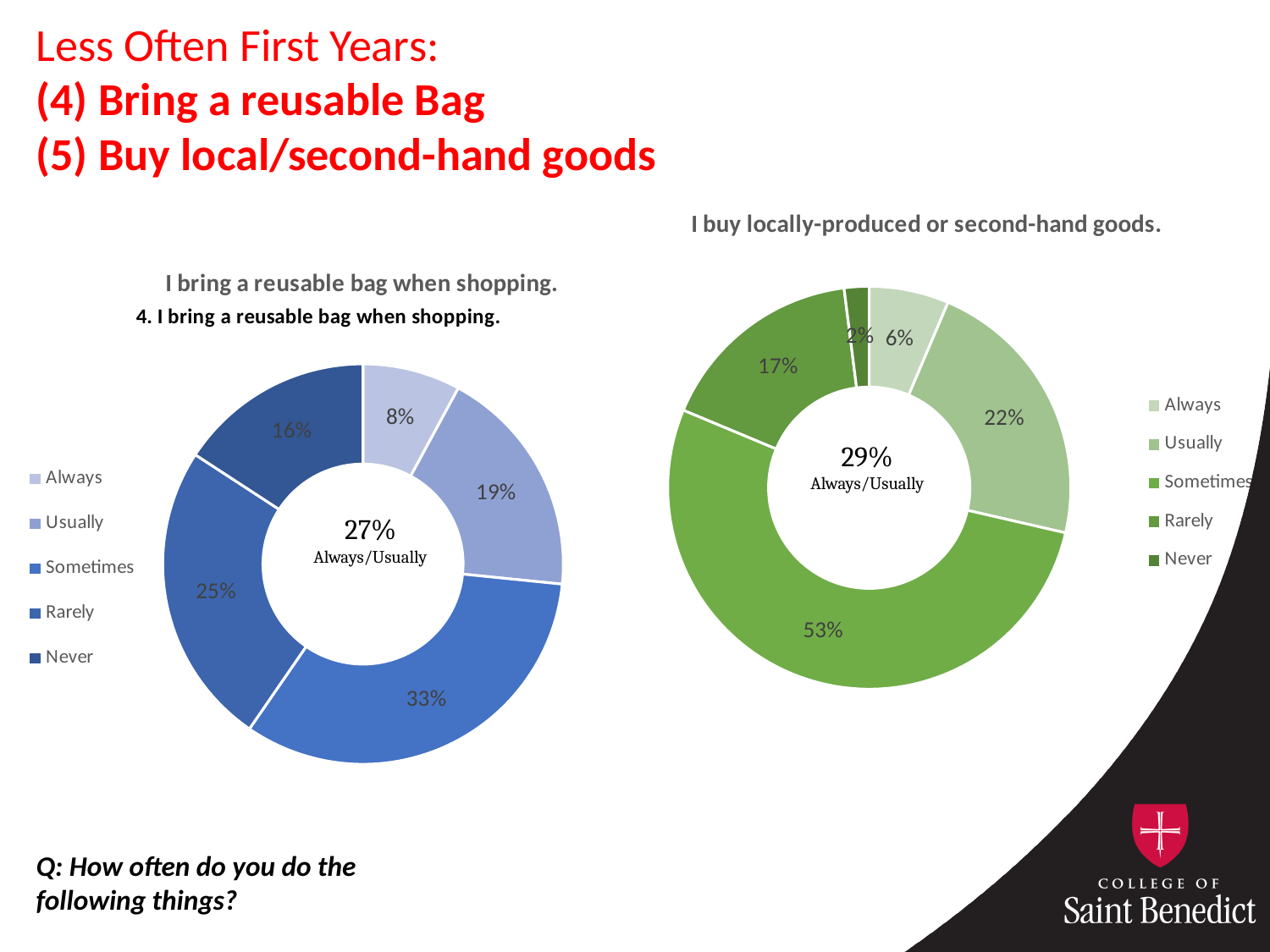
In the chart titled "I bring a reusable bag when shopping.", what is the difference between the Rarely and Never percentages? 9% In the chart titled "I buy locally-produced or second-hand goods.", which category has the smallest share? Never What combined Always/Usually percentage is printed in the centre of the chart titled "I buy locally-produced or second-hand goods."? 29% How many categories does the legend of the chart titled "I bring a reusable bag when shopping." list? 5 In the chart titled "I bring a reusable bag when shopping.", what percentage is shown for Sometimes? 33% What kind of chart is the chart titled "I buy locally-produced or second-hand goods."? Doughnut chart What combined Always/Usually percentage is printed in the centre of the chart titled "I bring a reusable bag when shopping."? 27% In the chart titled "I buy locally-produced or second-hand goods.", which is larger, Usually or Rarely? Usually In the chart titled "I bring a reusable bag when shopping.", which category has the largest share? Sometimes In the chart titled "I buy locally-produced or second-hand goods.", what percentage is shown for Never? 2% In the chart titled "I bring a reusable bag when shopping.", what percentage is shown for Always? 8% In the chart titled "I buy locally-produced or second-hand goods.", what percentage is shown for Rarely? 17%